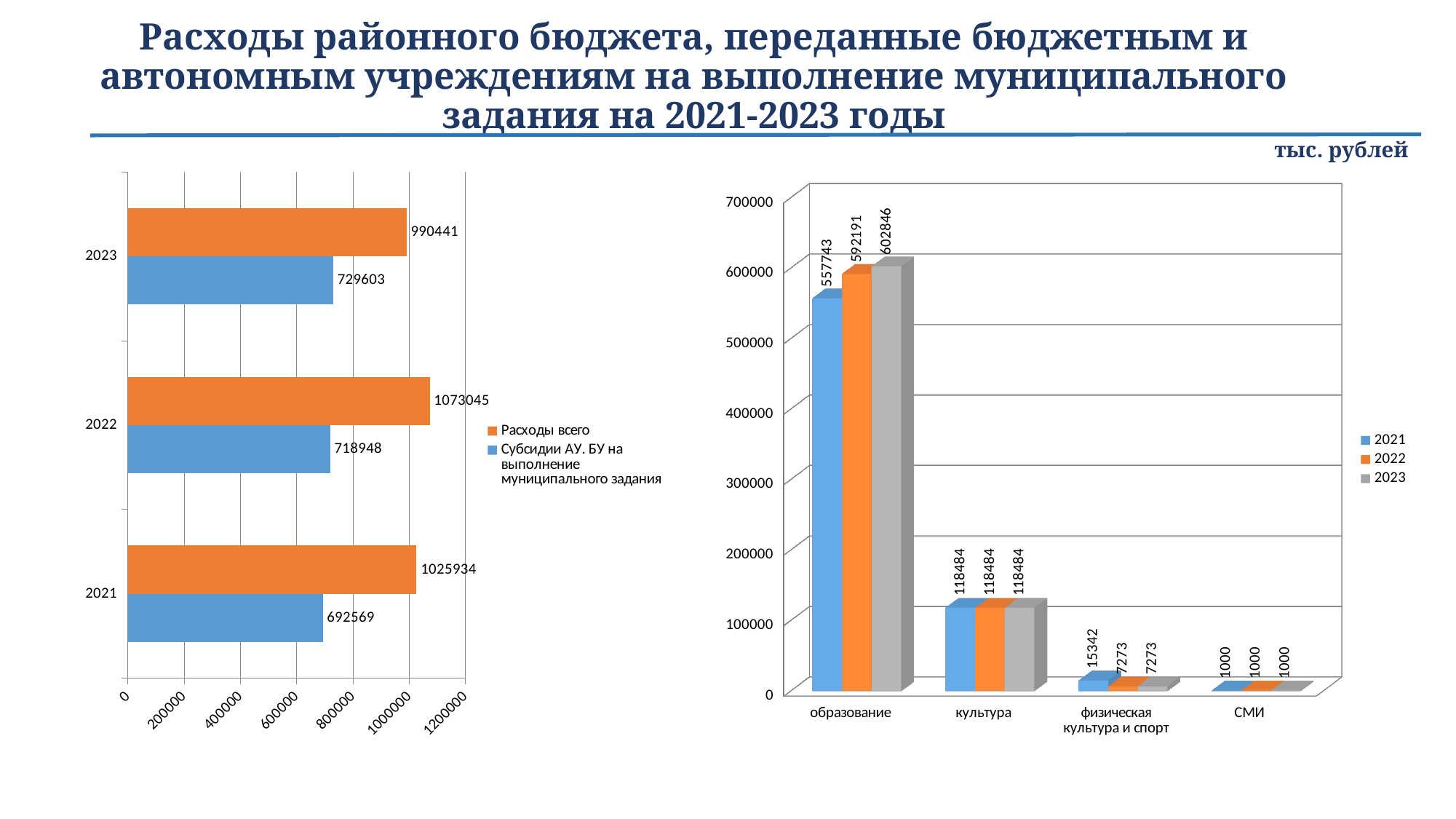
On the left chart, how many series does the legend list? 2 On the right chart, how many categories are shown on the x axis? 4 What kind of chart is the right chart? bar chart On the left chart, what is the value of Субсидии АУ, БУ на выполнение муниципального задания for 2021? 692569 On the right chart, which category has the lowest values? СМИ On the left chart, do the values of Субсидии АУ, БУ на выполнение муниципального задания rise or fall from 2021 to 2023? rise On the right chart, is the value for образование in 2021 greater or less than 500000? greater On the left chart, which year has the highest value of Расходы всего? 2022 On the right chart, what is the value for образование in 2023? 602846 On the left chart, what is the difference between Расходы всего and Субсидии АУ, БУ на выполнение муниципального задания in 2023? 260838 On the left chart, what is the value of Расходы всего for 2022? 1073045 On the right chart, what is the value for физическая культура и спорт in 2021? 15342